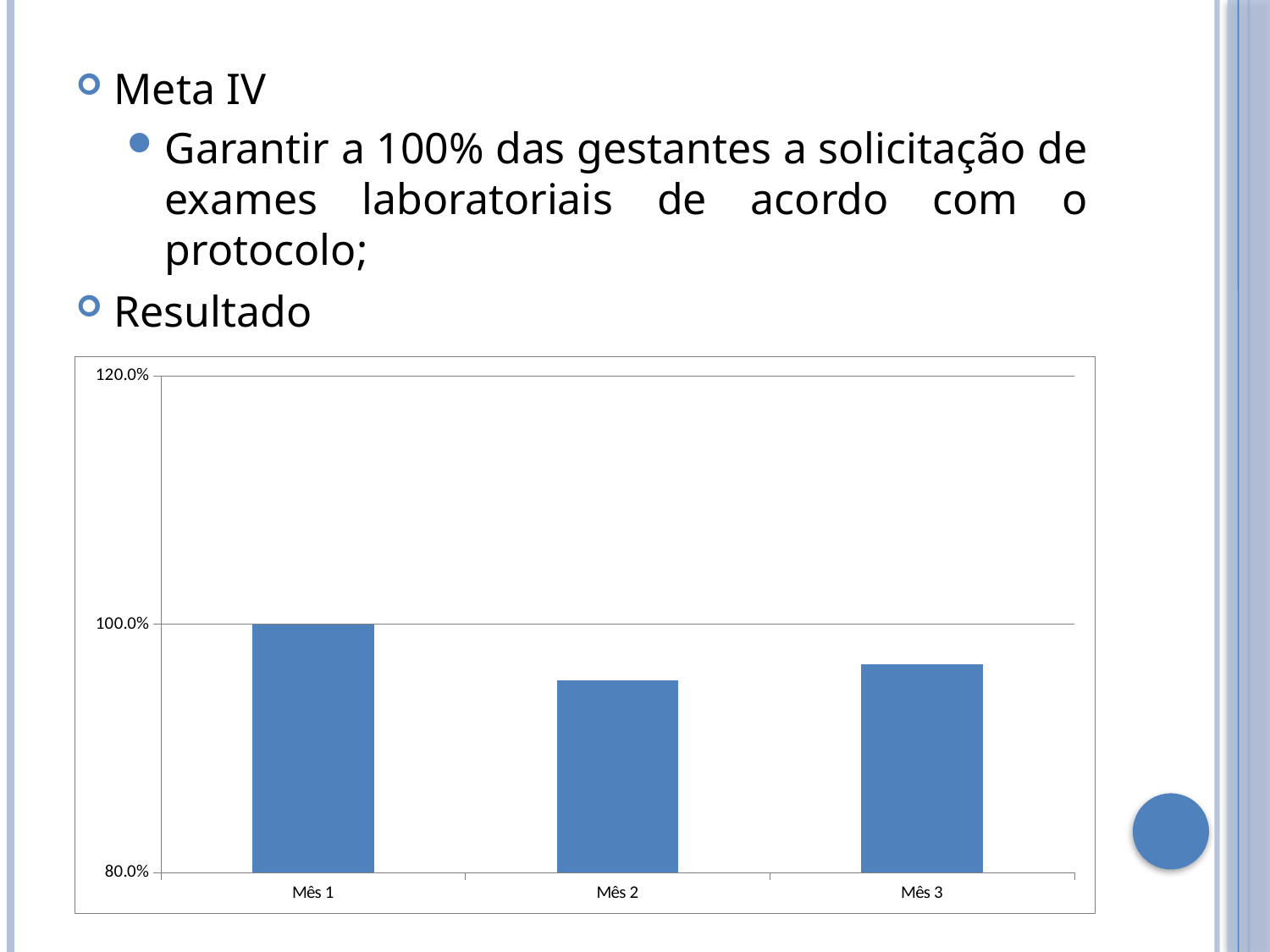
Does the value rise or fall from Mês 1 to Mês 2? fall Is the value for Mês 3 greater or less than 100.0%? less What kind of chart is shown on the slide? bar chart Which month has the highest value? Mês 1 Is the value for Mês 2 greater or less than 80.0%? greater Which is larger, the value for Mês 2 or the value for Mês 3? Mês 3 Which is larger, the value for Mês 1 or the value for Mês 2? Mês 1 Which month has the lowest value? Mês 2 How many categories (bars) does the chart show? 3 Is the value for Mês 2 greater or less than 100.0%? less What is the value for Mês 1? 100.0% What is the highest value shown on the vertical axis? 120.0%